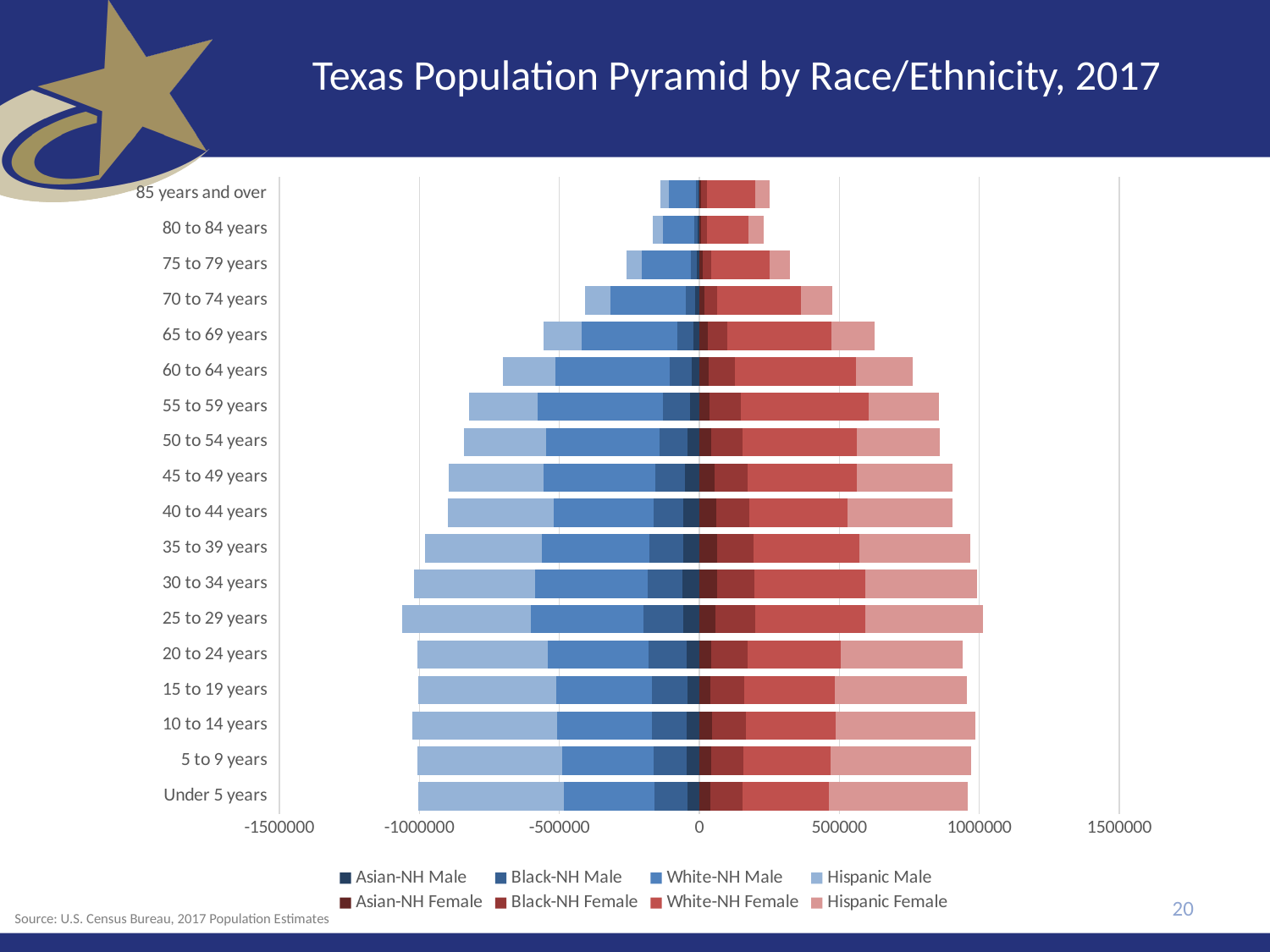
Which age group has the longest stacked bar on the female (right) side of the chart? 25 to 29 years Is the total female bar for 35 to 39 years greater or less than 500000? greater Is the total female bar for 85 years and over greater or less than 500000? less Which legend entry is shown in the lightest blue colour? Hispanic Male What kind of chart is shown on the slide? Bar chart (population pyramid) How many age groups are shown on the vertical axis of the chart? 18 Which age group has the longer female stacked bar: 60 to 64 years or 65 to 69 years? 60 to 64 years What is the title of the chart? Texas Population Pyramid by Race/Ethnicity, 2017 Which age group has the shortest stacked bar on the female (right) side of the chart? 80 to 84 years Which age group has the longest stacked bar on the male (left) side of the chart? 25 to 29 years How many series does the legend list? 8 Moving up the chart from 25 to 29 years to 85 years and over, do the stacked bars generally get longer or shorter? shorter